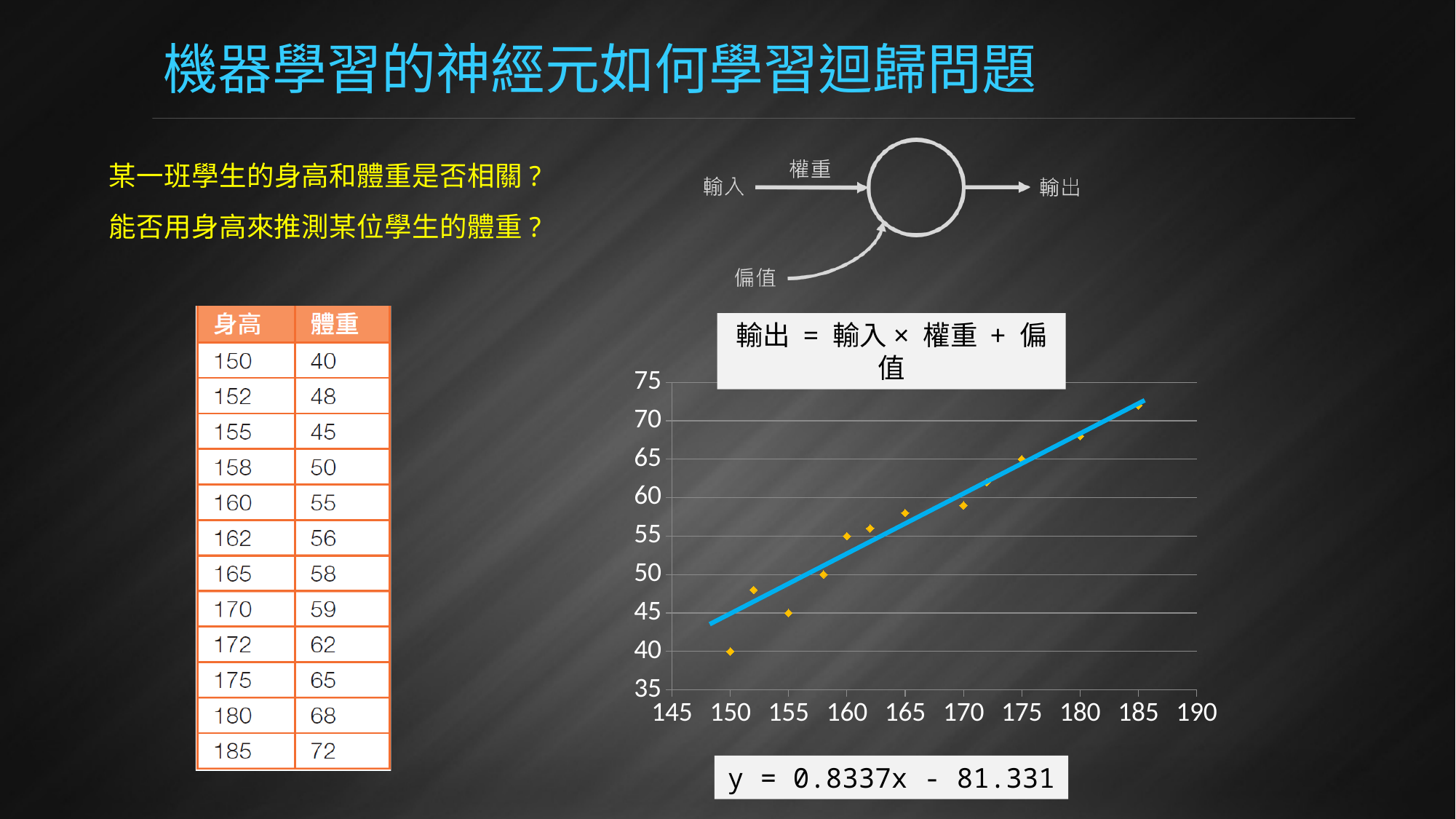
What kind of chart is shown on the right of the slide? scatter chart How many data points are plotted in the scatter chart? 12 Which height has the highest weight value in the chart? 185 Do the plotted weight values rise or fall as height increases along the x axis? rise Which is larger, the weight value at height 152 or at height 155? 152 What is the difference between the weight values at heights 185 and 150? 32 Is the weight value for a height of 185 greater or less than 70? greater Is the weight value for a height of 155 greater or less than 50? less What is the weight value plotted for a height of 170? 59 What is the weight value plotted for a height of 150? 40 Which height has the lowest weight value in the chart? 150 What is the weight value plotted for a height of 185? 72